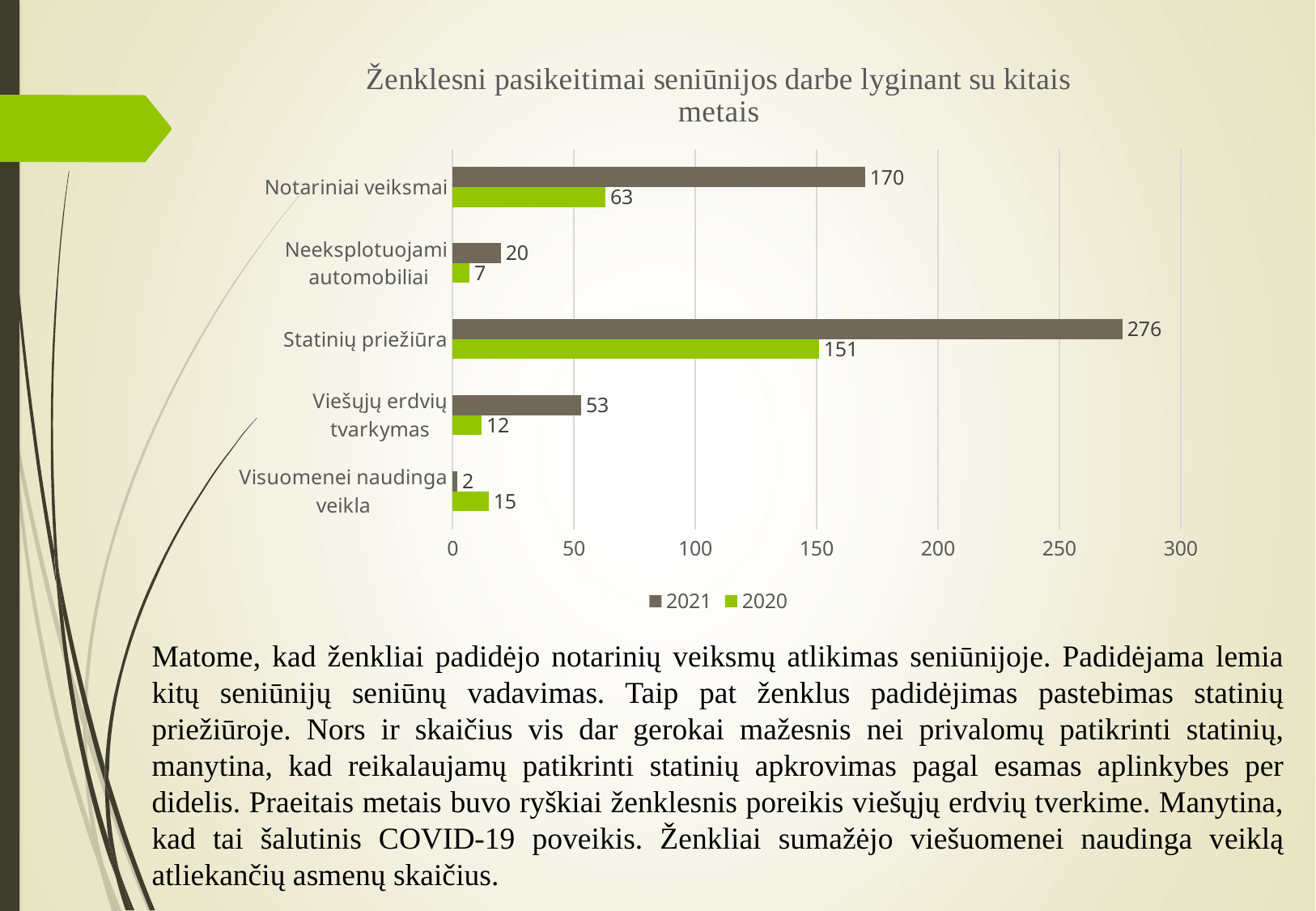
Which colour represents the 2020 series in the chart? green What is the difference between the 2021 and 2020 values for Notariniai veiksmai? 107 Which category has the highest 2021 value? Statinių priežiūra Which category has the lowest 2020 value? Neeksplotuojami automobiliai How many categories are shown on the chart? 5 What is the 2020 value for Visuomenei naudinga veikla? 15 How many series does the legend list? 2 What is the 2020 value for Statinių priežiūra? 151 What is the 2021 value for Notariniai veiksmai? 170 Which is larger for Visuomenei naudinga veikla, the 2021 value or the 2020 value? 2020 Is the 2021 value for Statinių priežiūra greater or less than 250? greater What kind of chart is shown on the slide? bar chart